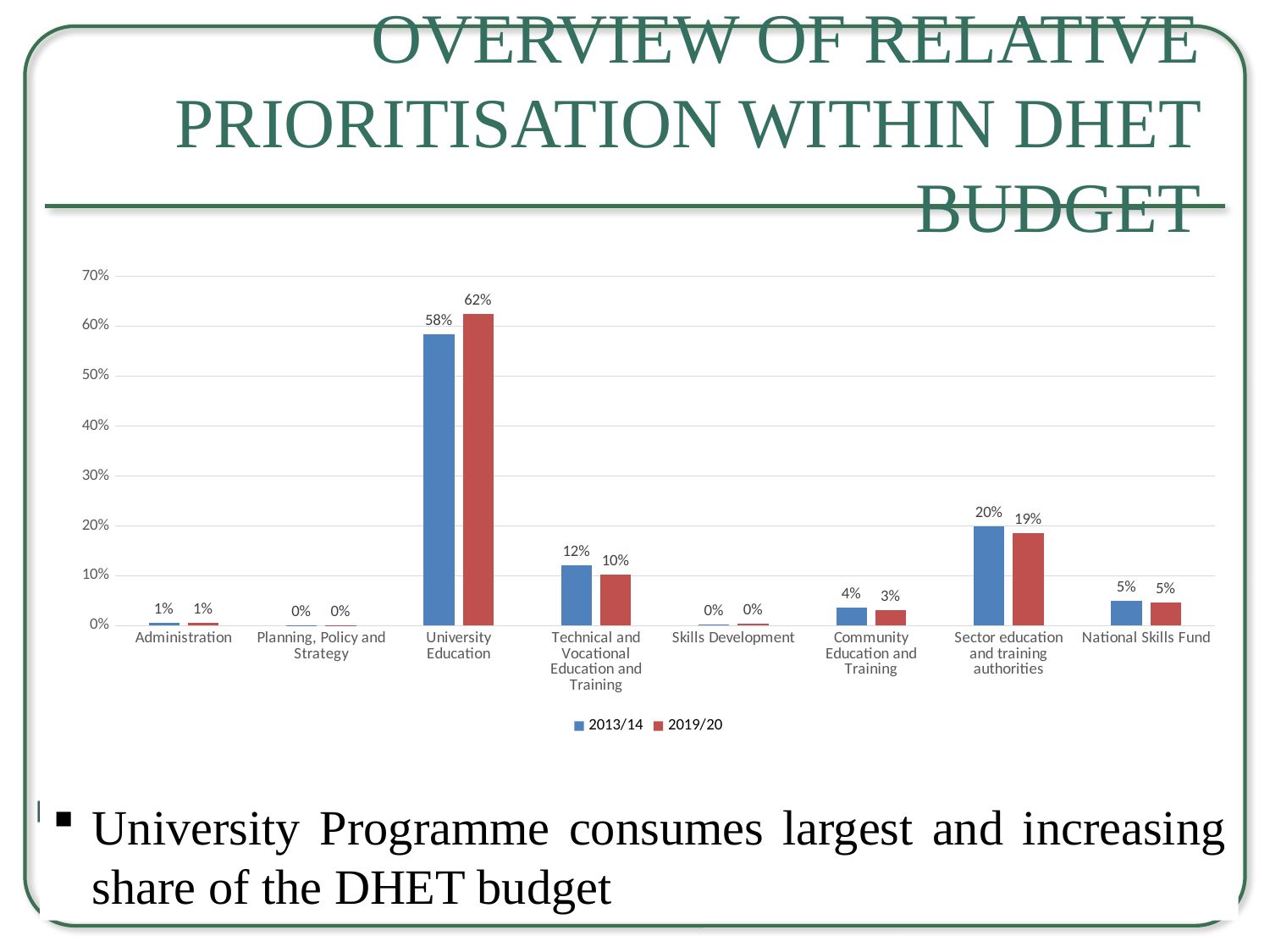
What is the value for University Education in 2019/20? 62% What is the value for Technical and Vocational Education and Training in 2019/20? 10% How many categories are shown on the x axis? 8 What is the difference between the 2019/20 and 2013/14 values for University Education? 4% What is the value for Community Education and Training in 2013/14? 4% What is the difference between the 2013/14 and 2019/20 values for Technical and Vocational Education and Training? 2% Which category has the highest value in 2013/14? University Education How many series does the legend list? 2 What is the value for Sector education and training authorities in 2013/14? 20% Which series is shown in red in the legend? 2019/20 What kind of chart is shown on the slide? Bar chart Which is larger for Sector education and training authorities: the 2013/14 value or the 2019/20 value? 2013/14